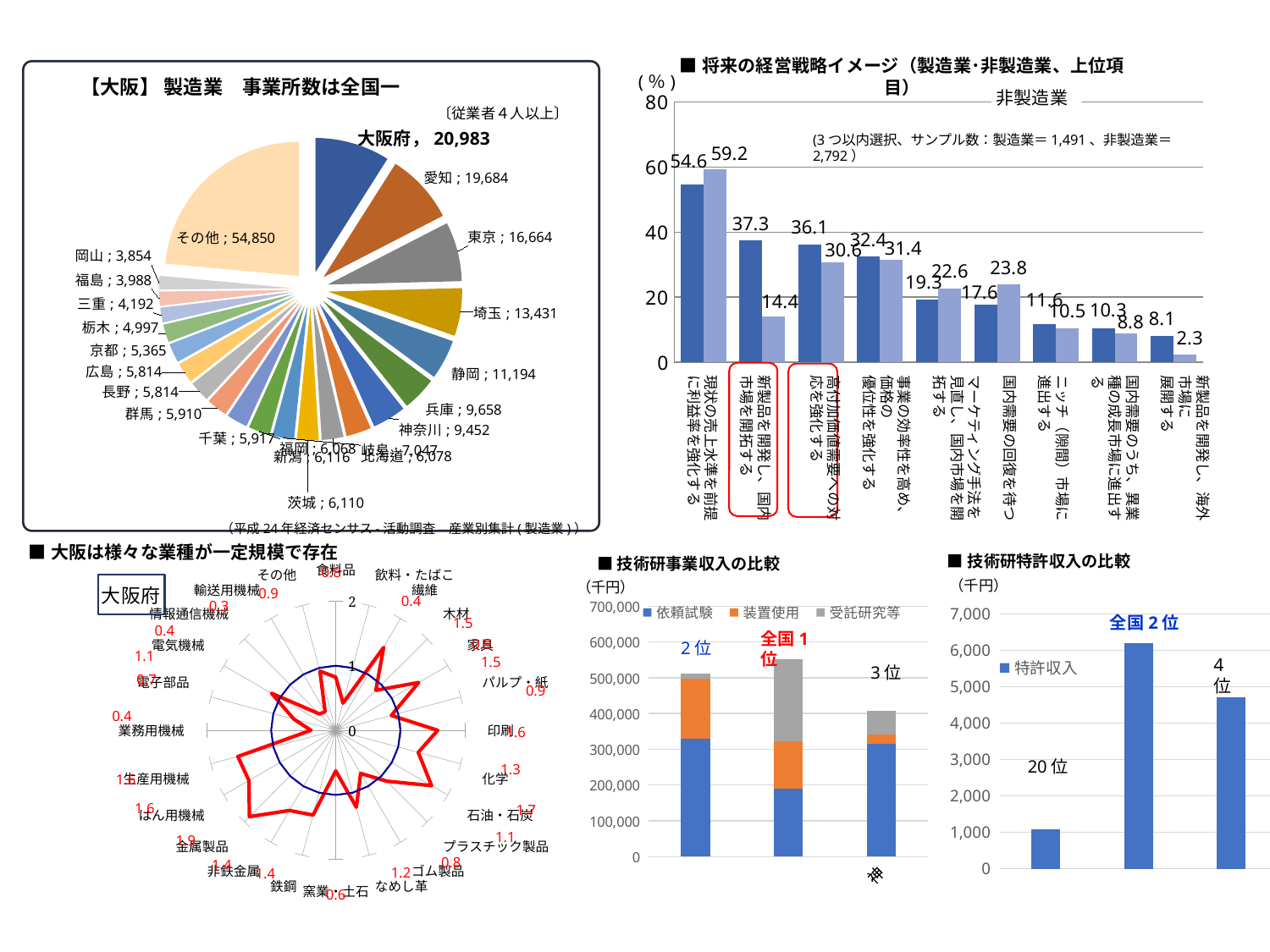
How many series does the legend list in the chart titled 技術研事業収入の比較? 3 In the bar chart titled 将来の経営戦略イメージ, what is the difference between the 製造業 and 非製造業 values for 新製品を開発し、海外市場に展開する? 5.8 In the chart titled 技術研特許収入の比較, which bar is the highest? 全国2位 In the pie chart titled 【大阪】 製造業 事業所数は全国一, what is the value for 大阪府? 20,983 In the pie chart titled 【大阪】 製造業 事業所数は全国一, what is the value for 東京? 16,664 In the pie chart titled 【大阪】 製造業 事業所数は全国一, what is the difference between the values for 大阪府 and 愛知? 1,299 In the pie chart titled 【大阪】 製造業 事業所数は全国一, which is larger, 兵庫 or 神奈川? 兵庫 In the bar chart titled 将来の経営戦略イメージ, what is the 非製造業 value for 現状の売上水準を前提に利益率を強化する? 59.2 In the chart titled 技術研事業収入の比較, is the total of the bar labelled 3位 greater or less than 500,000? less In the bar chart titled 将来の経営戦略イメージ, which category has the highest 製造業 value? 現状の売上水準を前提に利益率を強化する In the bar chart titled 将来の経営戦略イメージ, what is the 製造業 value for 新製品を開発し、国内市場を開拓する? 37.3 What kind of chart is the chart titled 大阪は様々な業種が一定規模で存在? radar chart